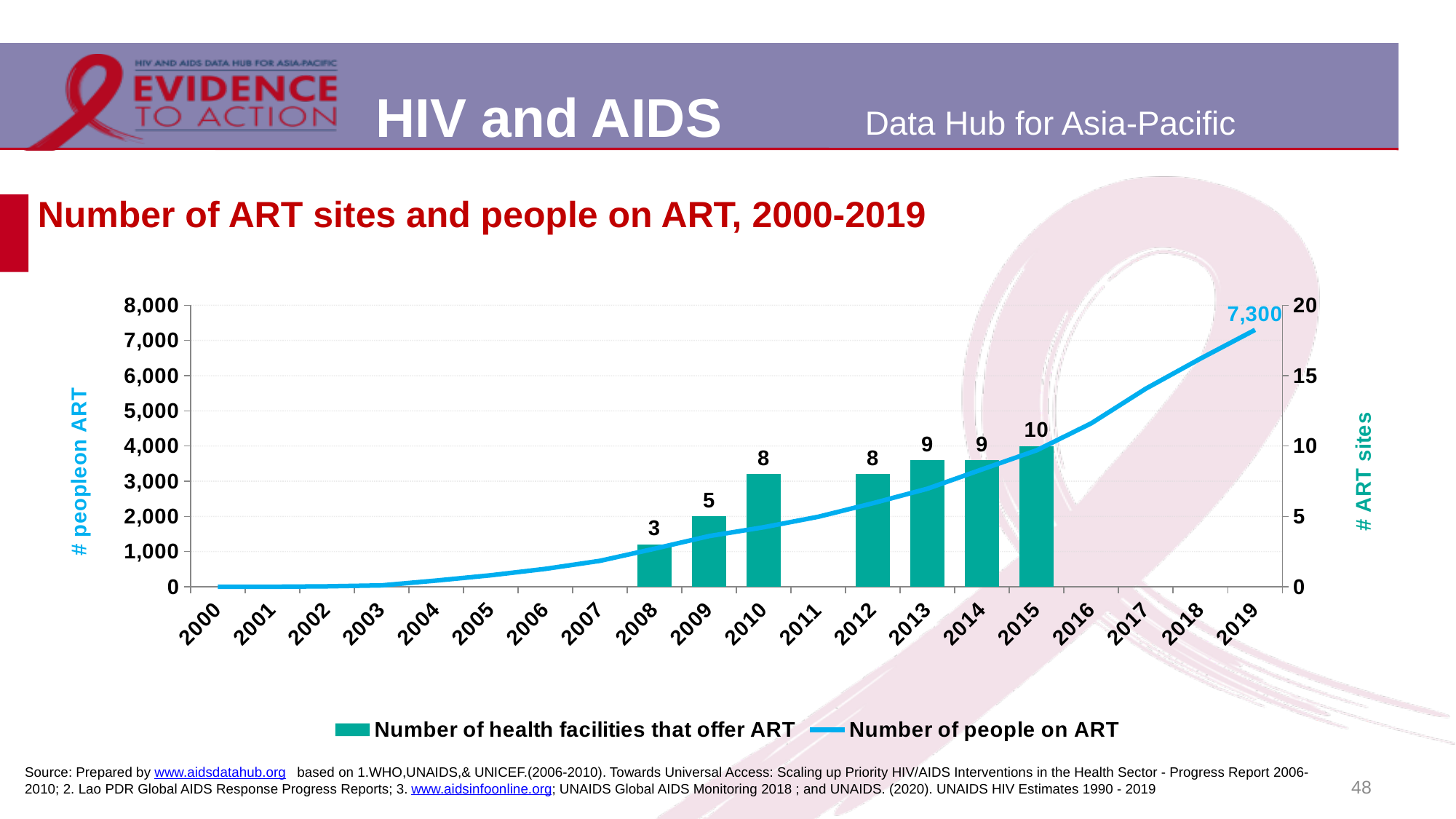
Which year had more health facilities that offer ART, 2009 or 2010? 2010 What is the overall trend of the number of people on ART from 2000 to 2019? Rising What is the difference between the number of health facilities that offer ART in 2015 and in 2008? 7 How many health facilities offered ART in 2015? 10 How many years have a bar for the number of health facilities that offer ART? 7 Which year has the lowest labelled number of health facilities that offer ART? 2008 What was the number of health facilities that offer ART in 2008? 3 Is the number of people on ART in 2016 greater or less than 4,000? greater In which year was the number of health facilities that offer ART highest? 2015 What is the number of people on ART in 2019, as labelled on the chart? 7,300 What is the label of the right-hand vertical axis? # ART sites How many series does the legend list? 2